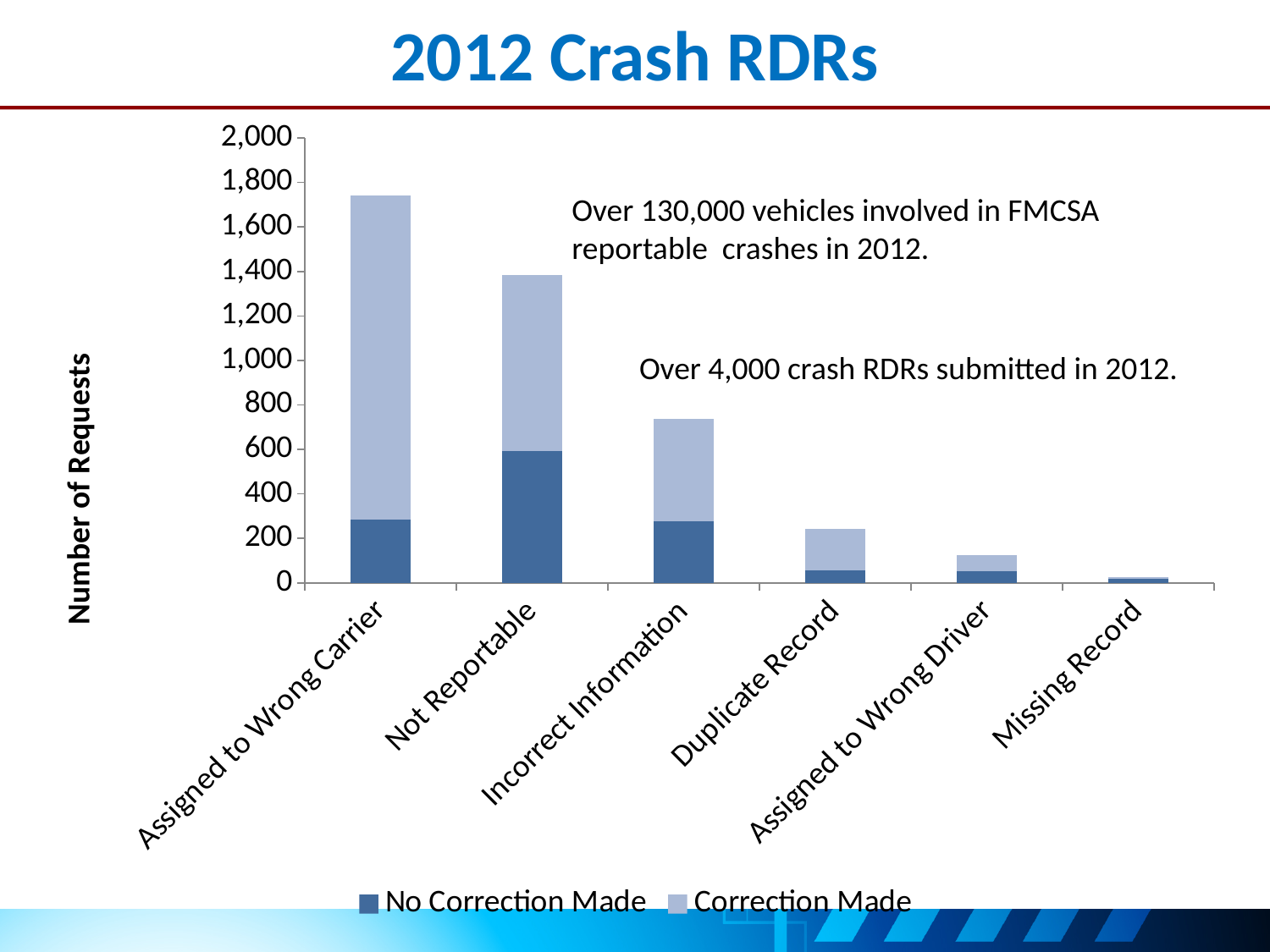
What is the label on the vertical axis of the chart? Number of Requests Is the total value for Incorrect Information greater or less than 800? less Do the total bar heights rise or fall moving from left to right along the x axis? fall Which category has the tallest total bar? Assigned to Wrong Carrier What kind of chart is shown on the slide? Stacked bar chart Is the total value for Assigned to Wrong Carrier greater or less than 1,600? greater Is the No Correction Made value for Not Reportable greater or less than 400? greater How many series does the chart's legend list? 2 How many categories are shown on the x axis of the chart? 6 What is the title of the chart? 2012 Crash RDRs Which category has the larger No Correction Made value, Not Reportable or Incorrect Information? Not Reportable Which category has the shortest total bar? Missing Record